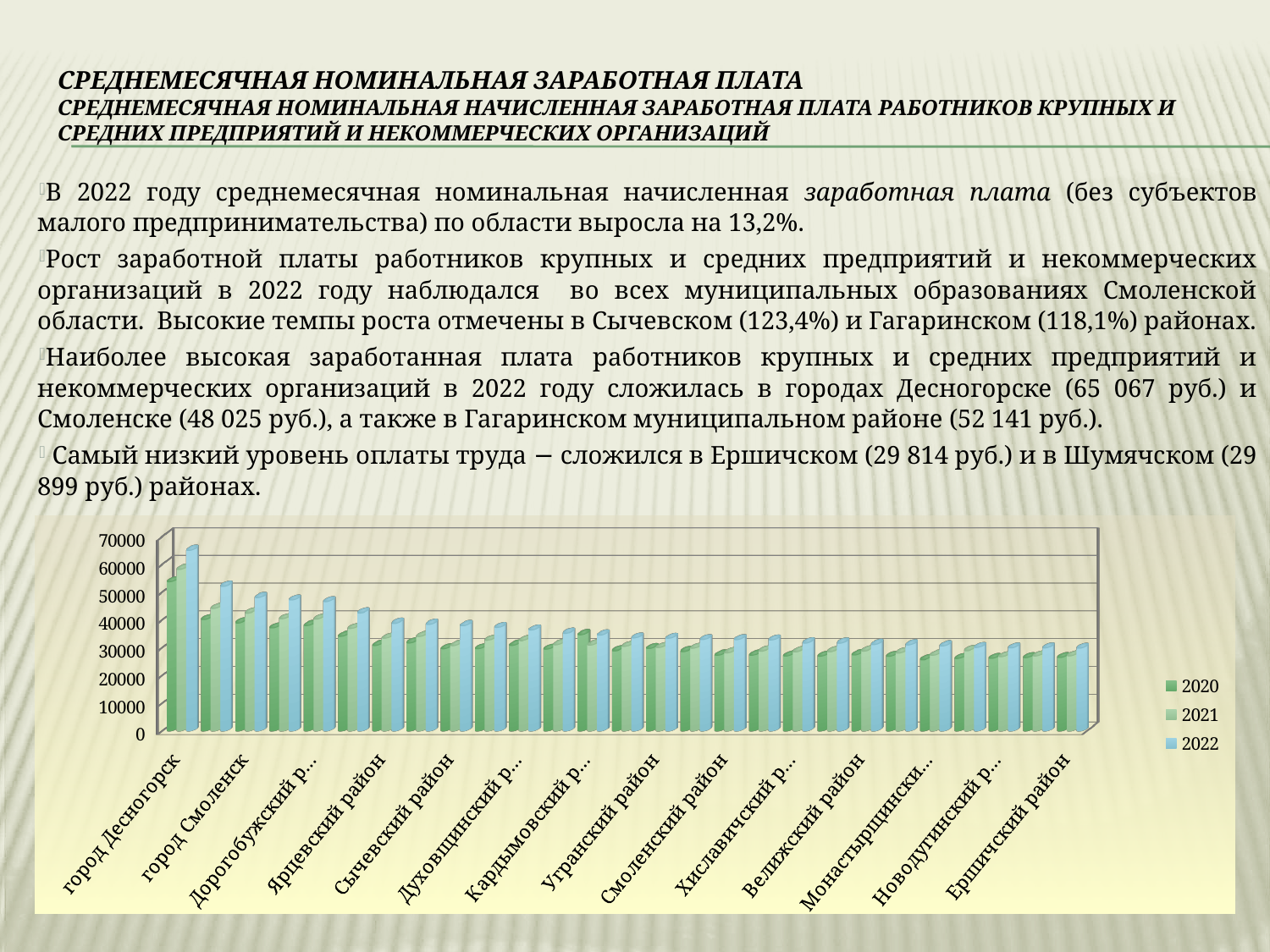
Which category has the highest 2022 value in the chart? город Десногорск Is the 2020 value for город Десногорск greater or less than 50000? greater Is the 2022 value for город Десногорск greater or less than 60000? greater Is the 2022 value for Ершичский район greater or less than 40000? less Do the 2022 values generally rise or fall moving from left to right along the x axis? fall How many series does the chart legend list? 3 Which is larger, the 2022 value for город Десногорск or the 2022 value for город Смоленск? город Десногорск Which years are listed in the chart legend? 2020, 2021, 2022 What kind of chart is shown on the slide? bar chart For город Десногорск, which is larger, the 2020 value or the 2022 value? 2022